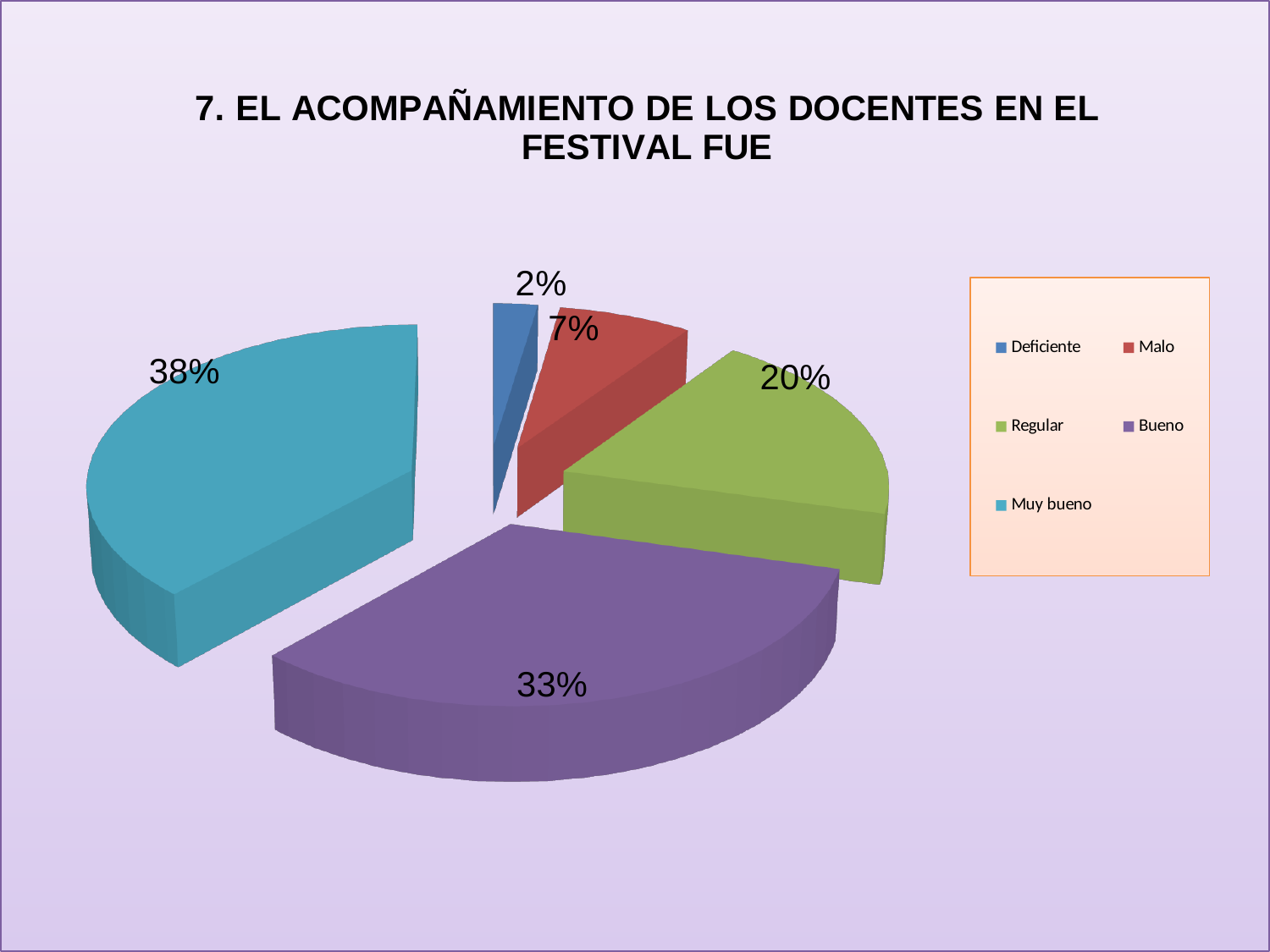
How many categories does the pie chart show? 5 What percentage of the pie chart is labelled Deficiente? 2% Which category has the smallest share of the pie chart? Deficiente Which category has the largest share of the pie chart? Muy bueno Which slice is larger, Regular or Malo? Regular What is the difference in percentage points between the Muy bueno and Bueno slices? 5 What type of chart is shown on the slide? Pie chart What percentage of the pie chart is labelled Bueno? 33% What percentage of the pie chart is labelled Malo? 7% What percentage of the pie chart is labelled Regular? 20% What percentage of the pie chart is labelled Muy bueno? 38% What colour is the Bueno slice in the pie chart? Purple